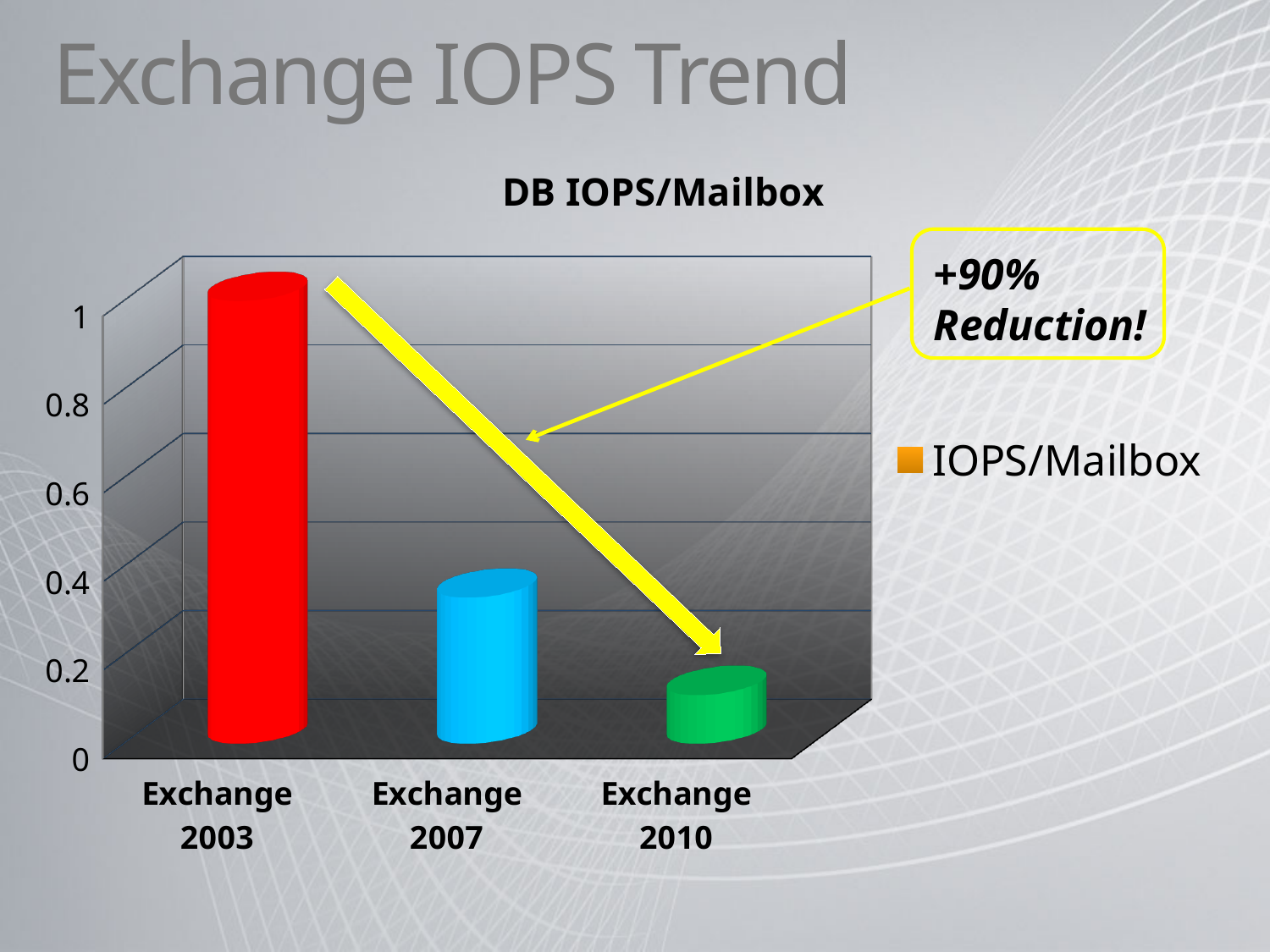
Do the values rise or fall from Exchange 2003 to Exchange 2010? fall How many categories are shown on the x axis of the chart? 3 Which category has the lowest DB IOPS/Mailbox value? Exchange 2010 Which has a larger value, Exchange 2007 or Exchange 2010? Exchange 2007 Which category has the highest DB IOPS/Mailbox value? Exchange 2003 What does the yellow callout on the slide say? +90% Reduction! Is the value for Exchange 2007 greater or less than 0.6? less What is the title of the chart? DB IOPS/Mailbox Is the value for Exchange 2010 greater or less than 0.4? less Is the value for Exchange 2003 greater or less than 0.8? greater How many series does the chart legend list? 1 What type of chart is shown on the slide? Bar chart